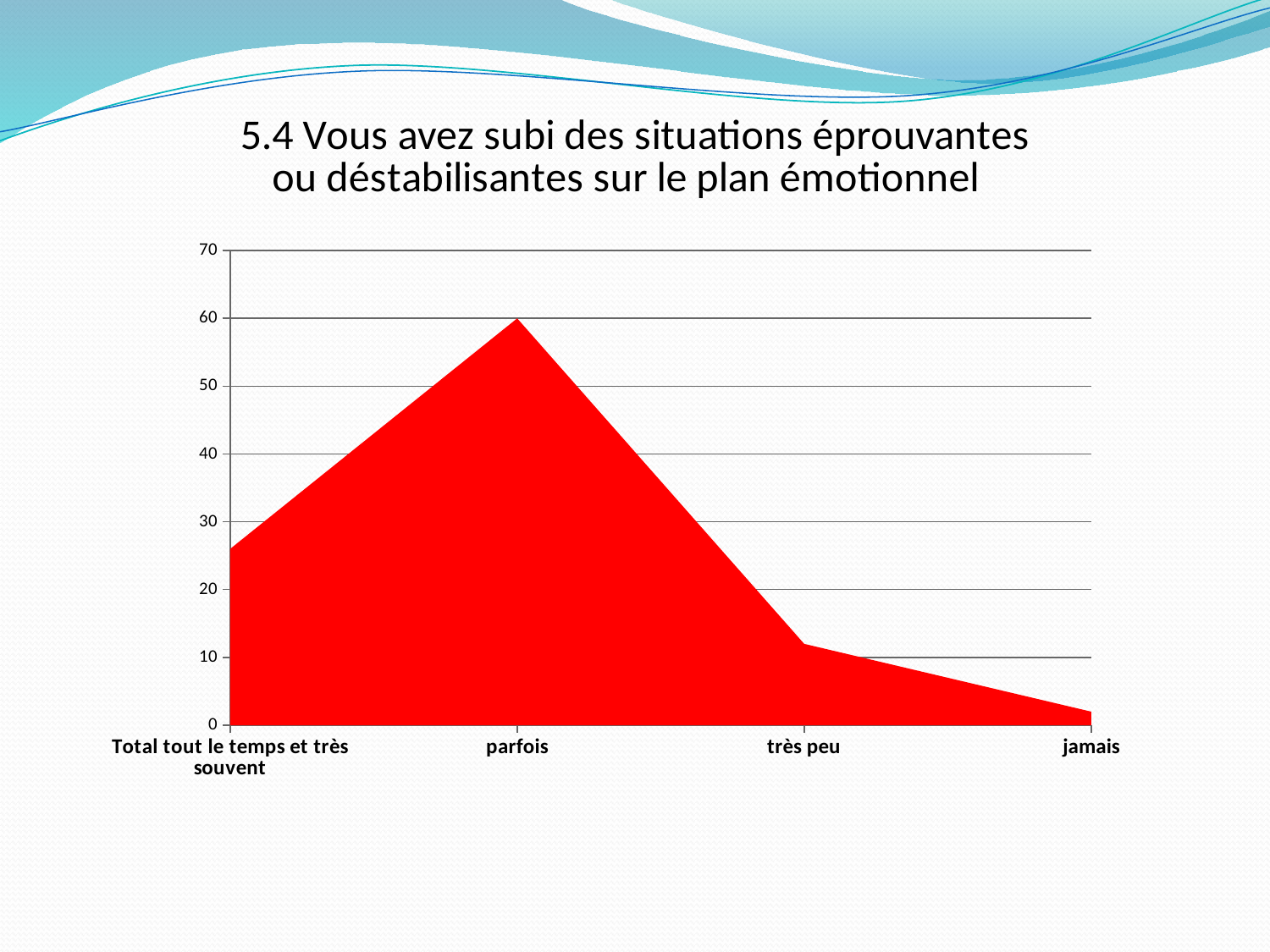
Which category has the lowest value in the chart? jamais Is the value for 'très peu' greater or less than 20? less Is the value for 'Total tout le temps et très souvent' greater or less than 20? greater Is the value for 'jamais' greater or less than 10? less What is the title of the slide containing the chart? 5.4 Vous avez subi des situations éprouvantes ou déstabilisantes sur le plan émotionnel Do the values rise or fall along the x axis from 'parfois' to 'jamais'? fall How many categories are shown on the x axis of the chart? 4 What kind of chart is shown on the slide? area chart Which category has the highest value in the chart? parfois Which has the larger value, 'Total tout le temps et très souvent' or 'très peu'? Total tout le temps et très souvent